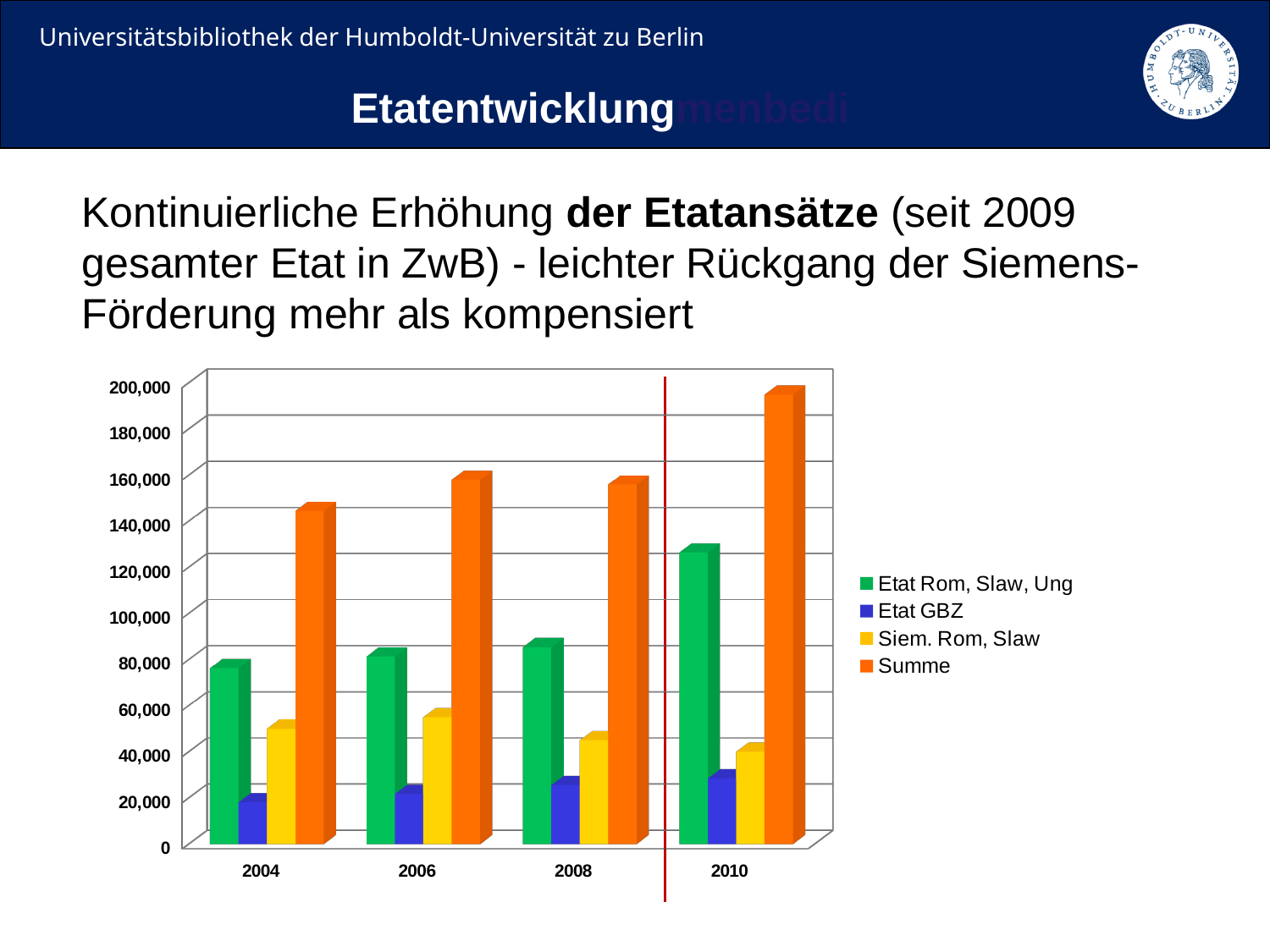
In which year is the Summe value highest? 2010 Does the Etat Rom, Slaw, Ung series rise or fall from 2004 to 2010? rise What kind of chart is shown on the slide? Bar chart Is the value for Etat Rom, Slaw, Ung in 2010 greater or less than 120,000? greater How many series does the chart's legend list? 4 In which year is the Summe value lowest? 2004 Is the value for Etat GBZ in 2010 greater or less than 40,000? less What colour represents the Summe series in the chart? Orange Which is larger, the Siem. Rom, Slaw value for 2006 or for 2010? 2006 Is the Summe value for 2010 greater or less than 180,000? greater In which year is the Siem. Rom, Slaw value lowest? 2010 How many years are shown on the x axis of the chart? 4